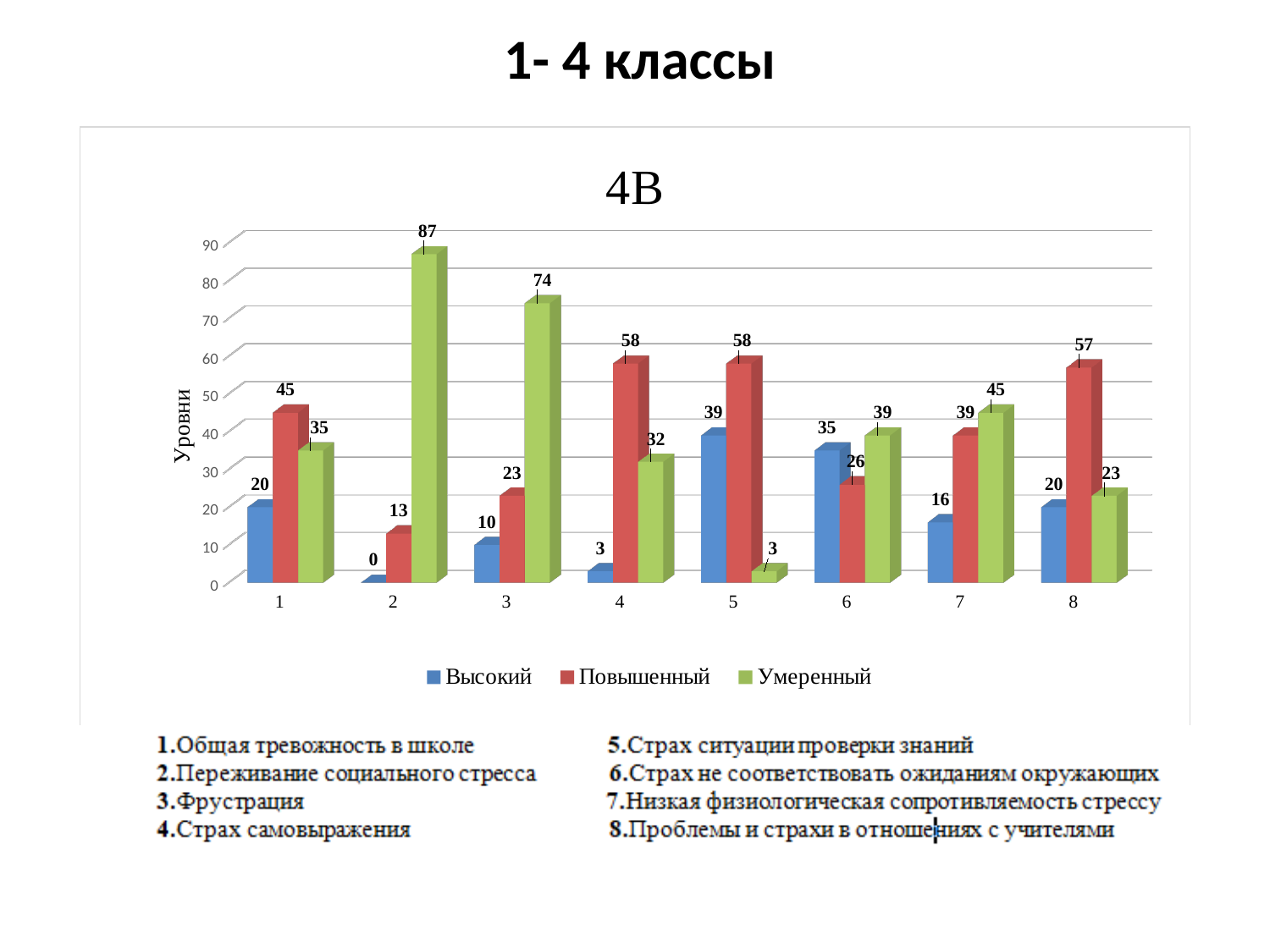
For category 6, which is larger: the Высокий value or the Повышенный value? Высокий Which category has the lowest value in the Высокий series? 2 What is the value of the Умеренный series for category 2? 87 What is the value of the Повышенный series for category 8? 57 What is the difference between the Повышенный and Высокий values for category 1? 25 What is the title of the chart? 4В What is the value of the Высокий series for category 5? 39 Which category has the highest value in the Умеренный series? 2 How many categories are shown on the x axis? 8 How many series does the legend list? 3 What kind of chart is shown on the slide? Bar chart What is the label of the vertical axis? Уровни